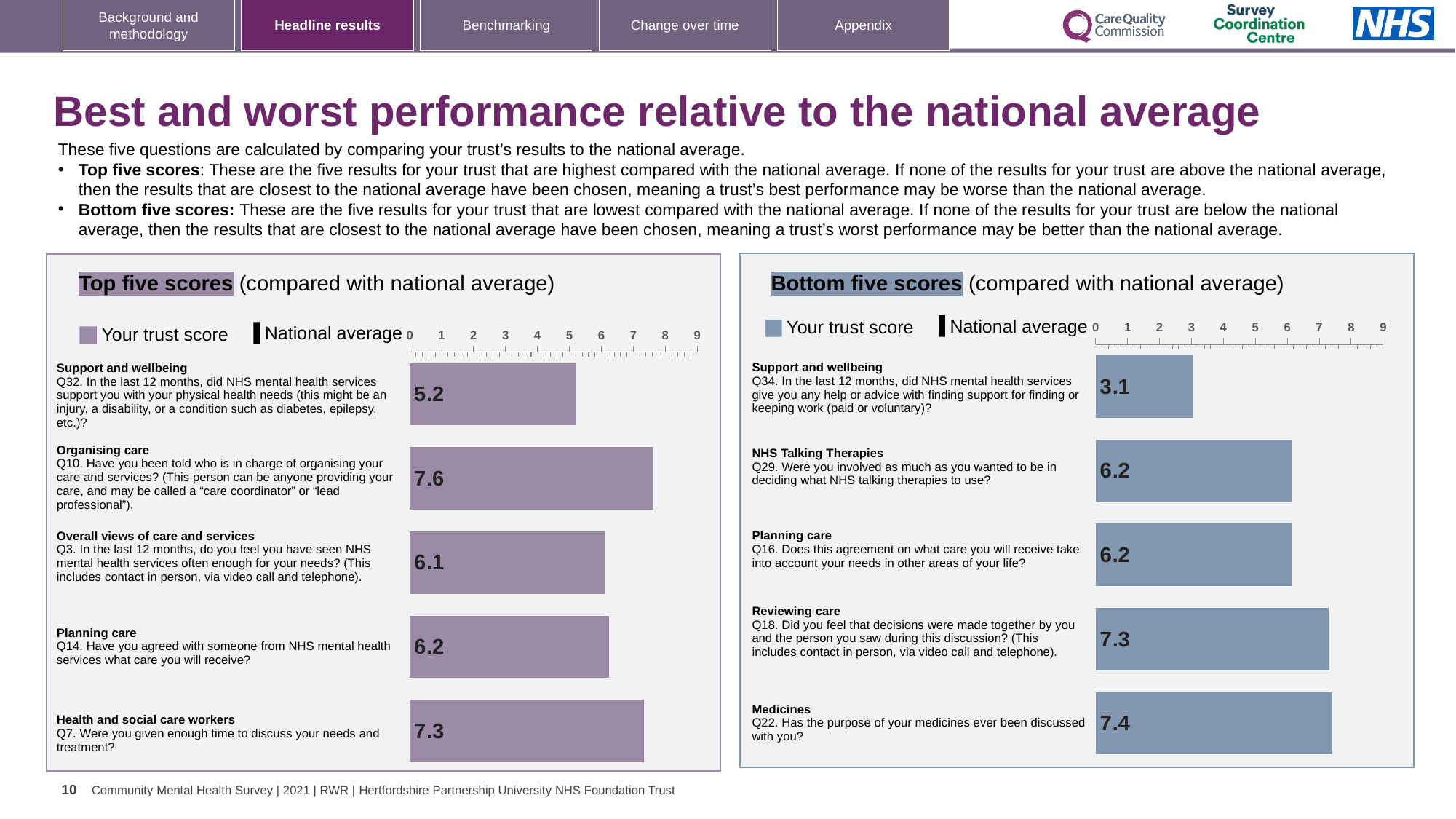
What type of chart is the Top five scores chart? Bar chart In the Top five scores chart, what is the trust score for Q10 (Organising care)? 7.6 In the Bottom five scores chart, what is the trust score for Q18 (Reviewing care)? 7.3 In the Bottom five scores chart, what is the trust score for Q34 (Support and wellbeing)? 3.1 In the Top five scores chart, what is the trust score for Q7 (Health and social care workers)? 7.3 In the Top five scores chart, which question has the highest trust score? Q10 (Organising care) How many bars are shown in the Bottom five scores chart? 5 In the Top five scores chart, which is larger: the score for Q3 or the score for Q14? Q14 In the Top five scores chart, which question has the lowest trust score? Q32 (Support and wellbeing) In the Bottom five scores chart, which question has the lowest trust score? Q34 (Support and wellbeing) In the Bottom five scores chart, what is the difference between the scores for Q22 and Q34? 4.3 In the Top five scores chart, what is the difference between the scores for Q10 and Q32? 2.4